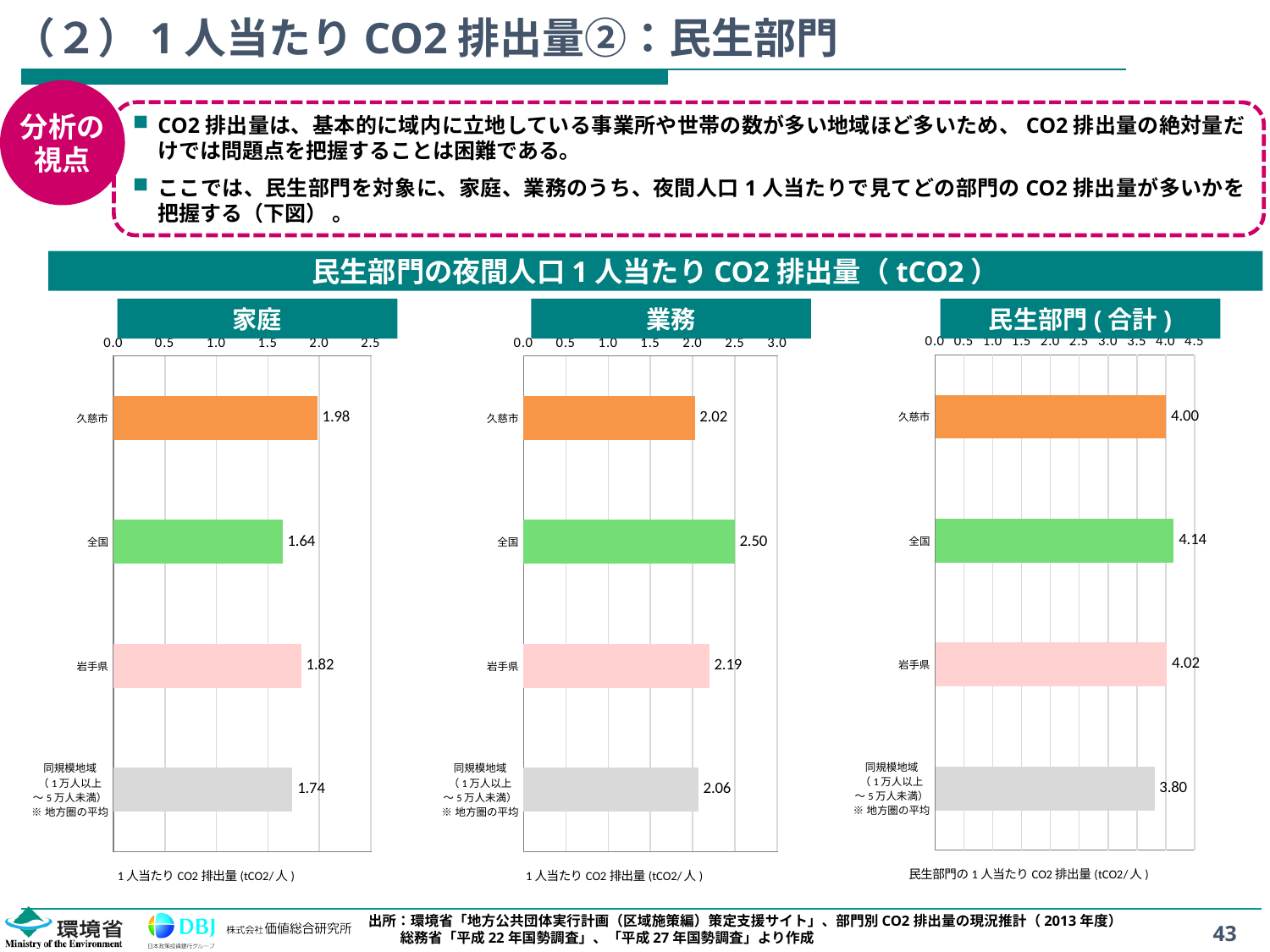
In the 業務 chart, which category has the lowest value? 久慈市 In the 家庭 chart, which category has the highest value? 久慈市 In the 家庭 chart, what is the value for 久慈市? 1.98 In the 業務 chart, is the value for 岩手県 greater or less than 2.0? greater In the 家庭 chart, what is the difference between the values for 岩手県 and 同規模地域? 0.08 In the 民生部門(合計) chart, what is the value for 同規模地域? 3.80 What type of chart is the 業務 chart? bar chart In the 民生部門(合計) chart, which is larger, the value for 全国 or the value for 同規模地域? 全国 How many categories are shown in the 家庭 chart? 4 In the 業務 chart, what is the value for 全国? 2.50 In the 民生部門(合計) chart, which category has the lowest value? 同規模地域 In the 業務 chart, what is the difference between the values for 全国 and 久慈市? 0.48